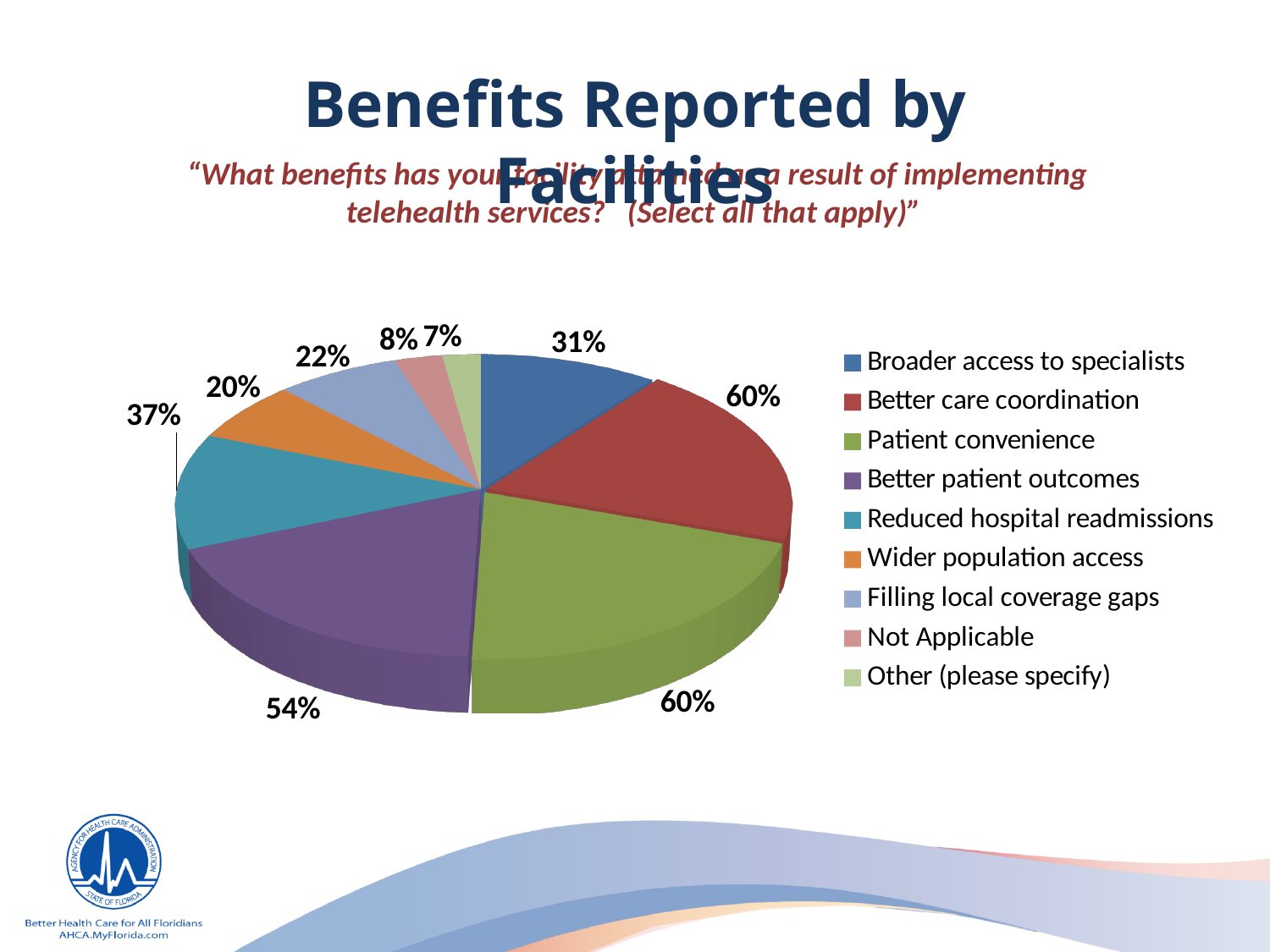
What percentage is shown for Broader access to specialists? 31% What percentage is shown for Wider population access? 20% What colour is the slice for Better care coordination? Red What percentage is shown for Filling local coverage gaps? 22% Which is larger, the percentage for Broader access to specialists or for Filling local coverage gaps? Broader access to specialists What percentage is shown for Better patient outcomes? 54% Which category has the lowest percentage? Other (please specify) What percentage is shown for Reduced hospital readmissions? 37% How many categories does the pie chart show? 9 What percentage is shown for Not Applicable? 8% What is the difference between the percentages for Better patient outcomes and Reduced hospital readmissions? 17% What kind of chart is shown on the slide? Pie chart